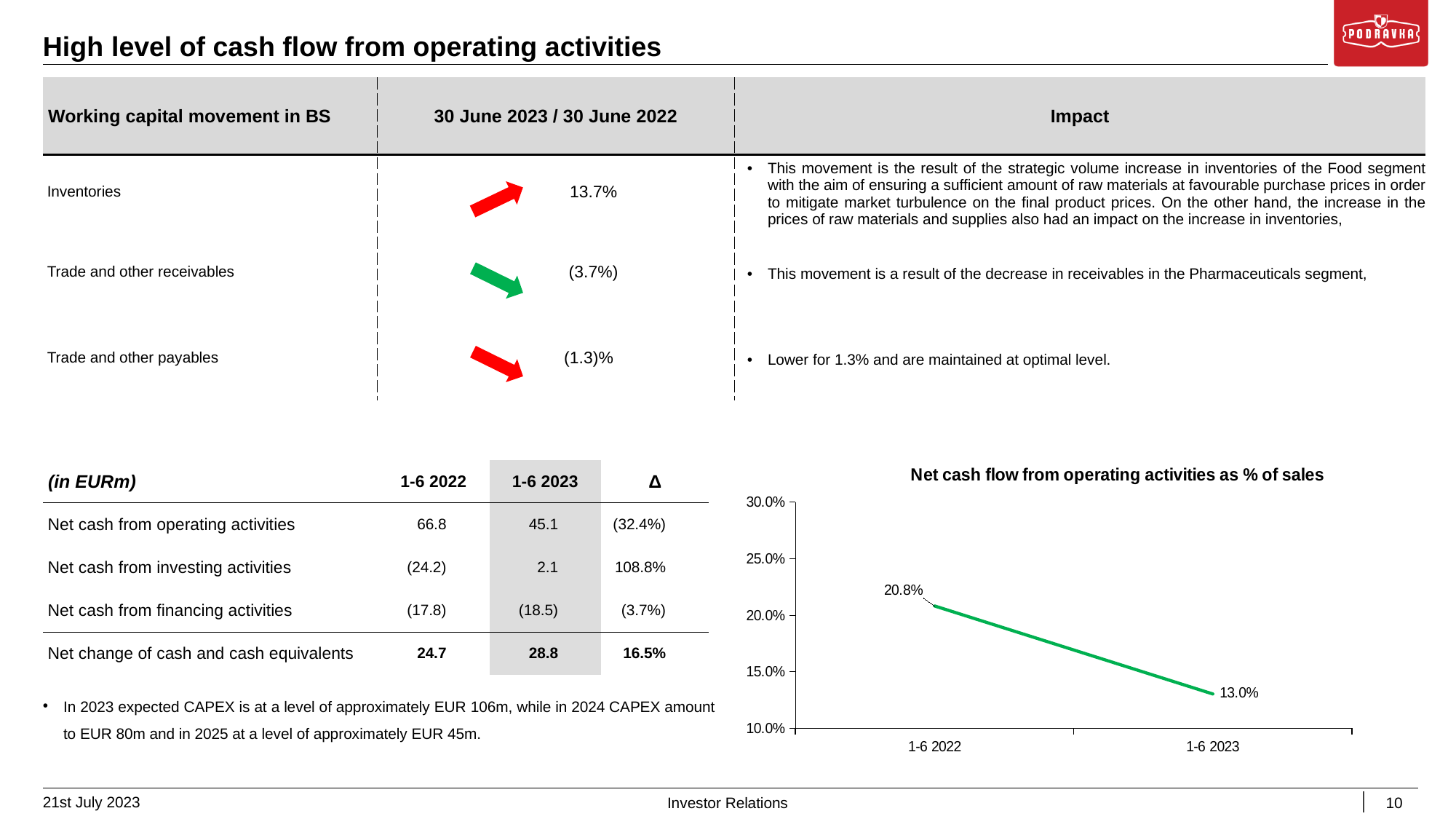
Is the value for 1-6 2023 greater or less than 15.0%? less What is the difference between the values for 1-6 2022 and 1-6 2023 in the chart? 7.8 percentage points What is the title of the chart on the slide? Net cash flow from operating activities as % of sales Is the value for 1-6 2022 greater or less than 20.0%? greater Which is larger in the chart, the value for 1-6 2022 or for 1-6 2023? 1-6 2022 Do the values in the chart rise or fall from 1-6 2022 to 1-6 2023? fall How many data points are plotted in the chart? 2 What is the value for 1-6 2023 in the chart? 13.0% Which period has the highest value in the chart? 1-6 2022 Which period has the lowest value in the chart? 1-6 2023 What is the value for 1-6 2022 in the chart? 20.8% What type of chart is shown on the slide? line chart